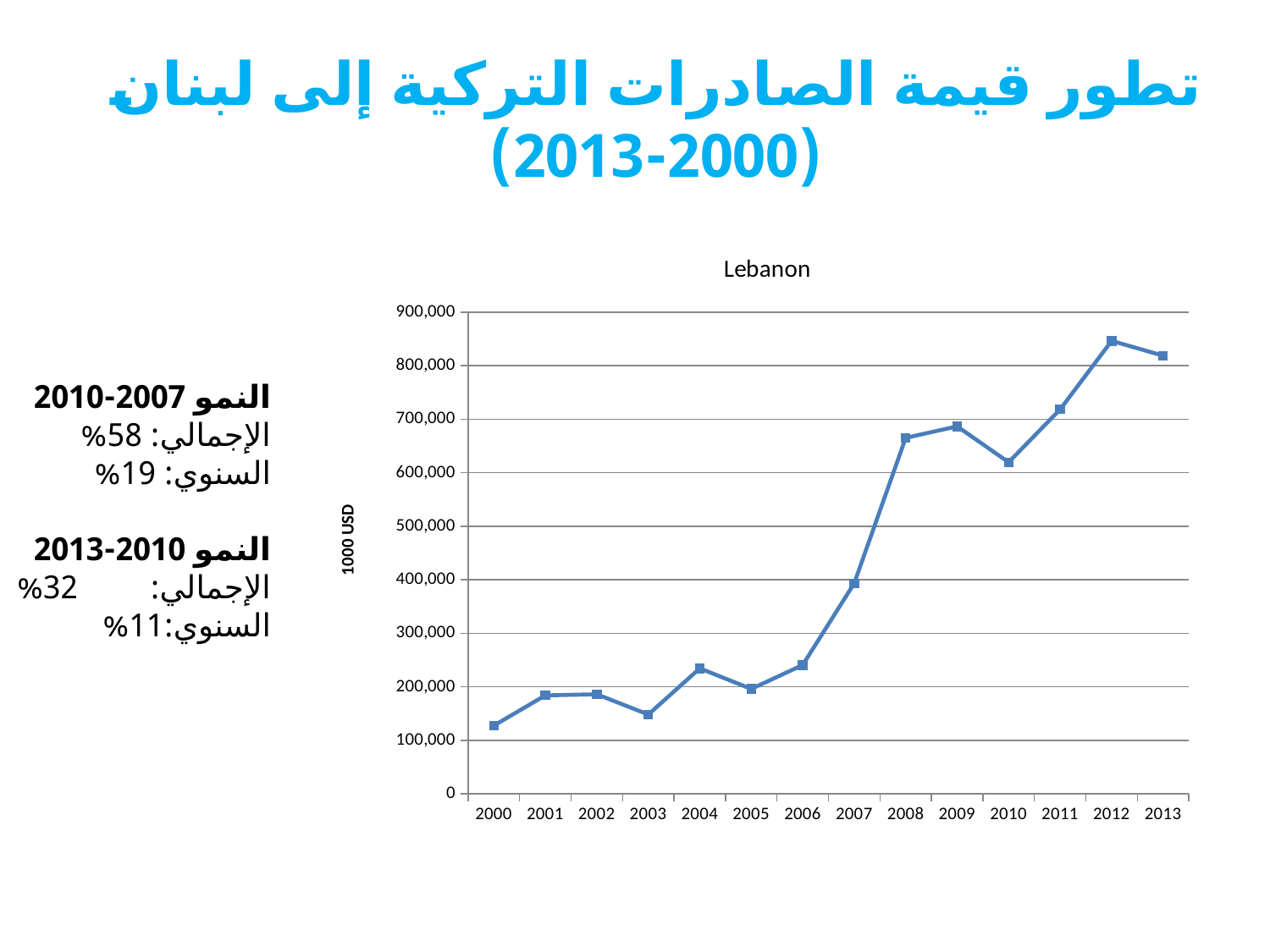
What is the title of the chart? Lebanon What kind of chart is shown on the slide? line chart Overall, do the values rise or fall from 2000 to 2013? rise Is the value for 2012 greater or less than 800,000? greater Is the value for 2000 greater or less than 200,000? less What is the label on the vertical axis of the chart? 1000 USD In which year is the plotted value lowest? 2000 Is the value for 2008 greater or less than 600,000? greater In which year is the plotted value highest? 2012 How many years are plotted on the x axis of the chart? 14 Which year has the larger value, 2009 or 2010? 2009